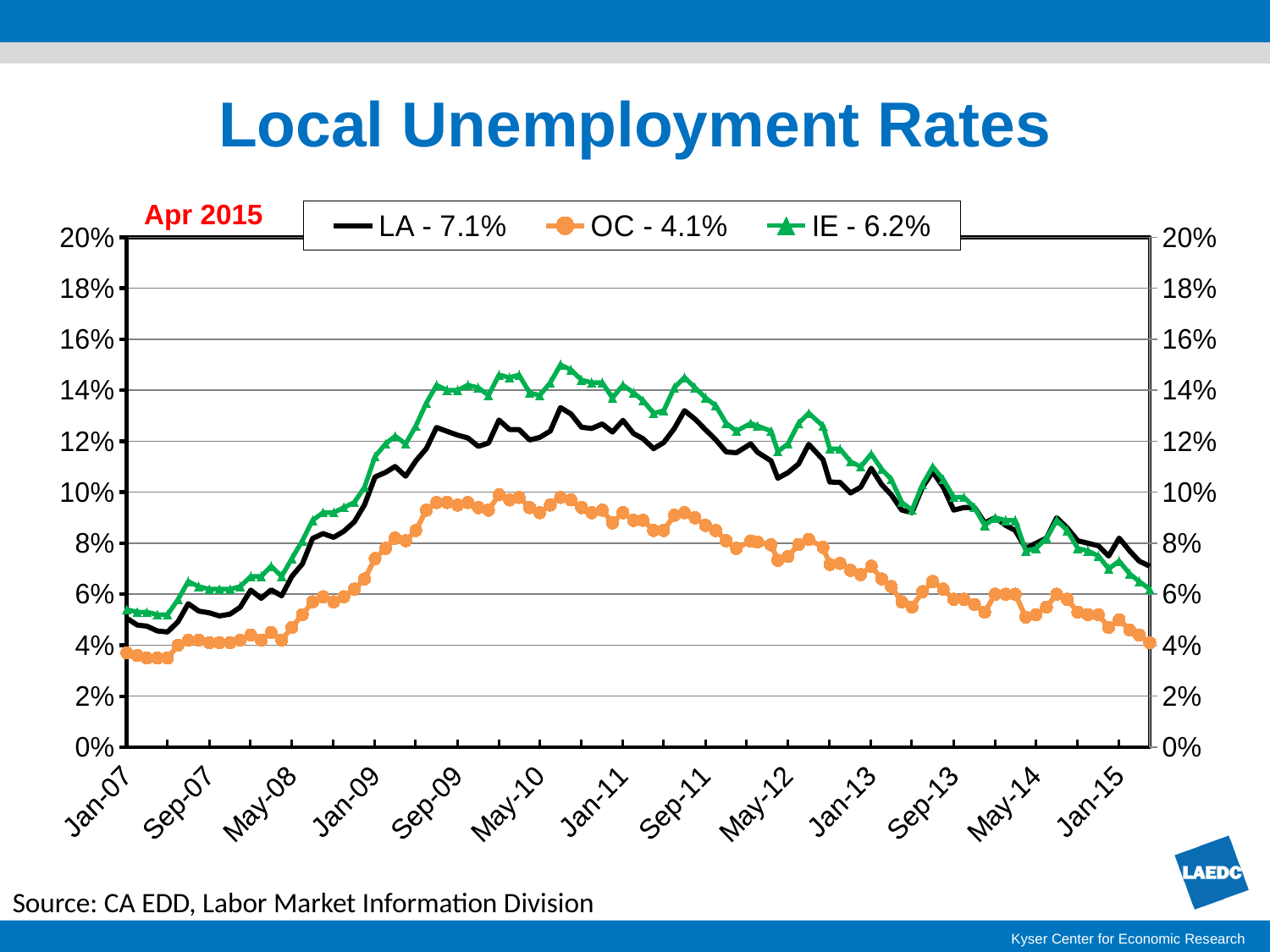
What is the LA unemployment rate shown for Apr 2015? 7.1% What is the IE unemployment rate shown for Apr 2015? 6.2% Does the LA unemployment rate rise or fall between Sep-11 and Jan-15? Fall Is the peak value of the OC series greater or less than 12%? less Which region has the lowest unemployment rate in Apr 2015? OC Which region has the highest unemployment rate in Apr 2015? LA Is the peak value of the IE series (around early 2010) greater or less than 14%? greater What kind of chart is shown on the slide? Line chart In Apr 2015, which is larger, the IE rate or the OC rate? IE What is the difference between the LA and OC unemployment rates in Apr 2015? 3.0 percentage points What is the OC unemployment rate shown for Apr 2015? 4.1% How many series does the legend list? 3